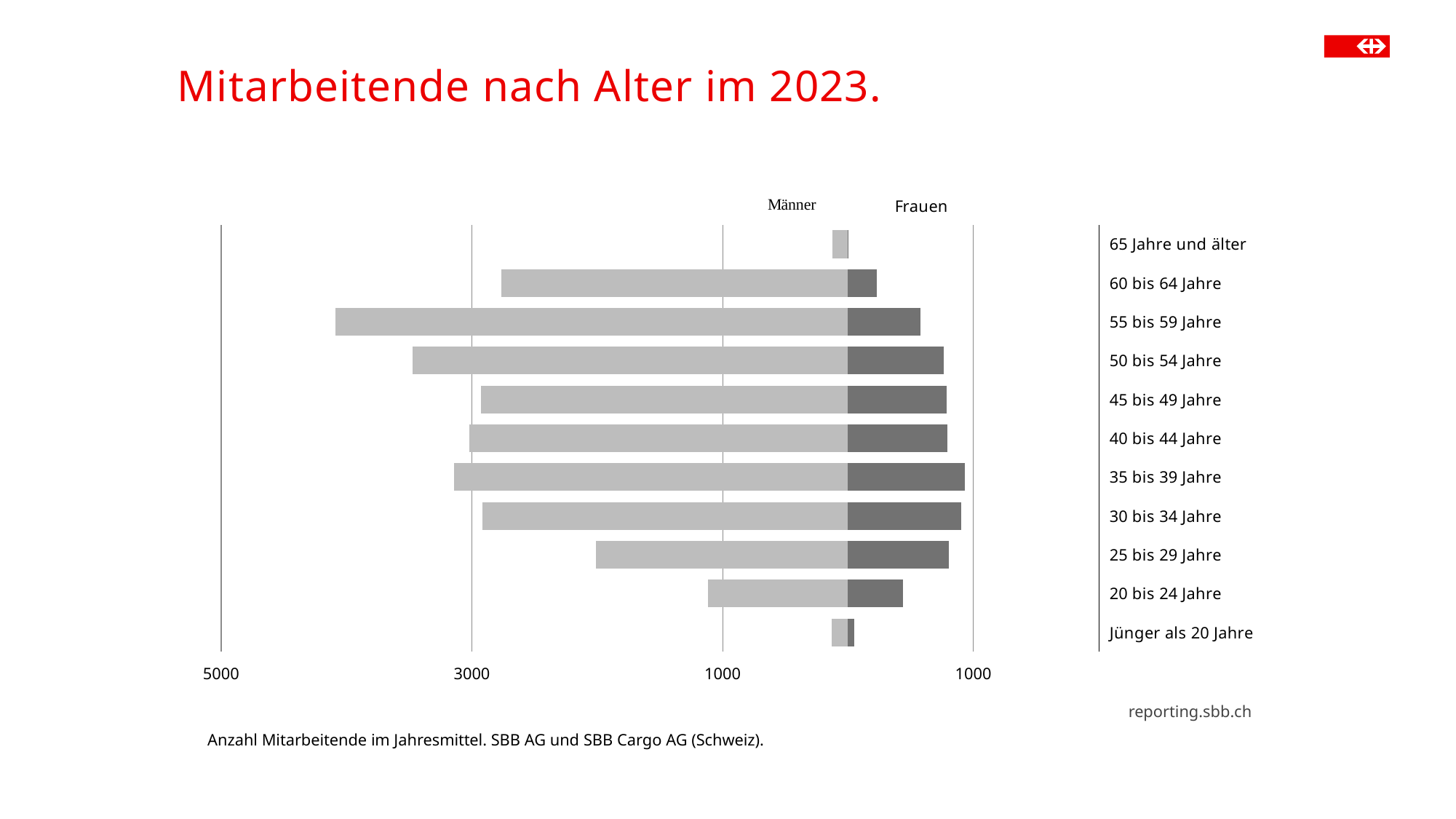
How many series does the chart show? 2 What is the title of the chart? Mitarbeitende nach Alter im 2023. Is the Männer value for 60 bis 64 Jahre greater or less than 3000? less Is the Männer value for 55 bis 59 Jahre greater or less than 3000? greater Which is larger for Männer: 55 bis 59 Jahre or 50 bis 54 Jahre? 55 bis 59 Jahre Is the Frauen value for 20 bis 24 Jahre greater or less than 1000? less Which age category has the highest value for Männer? 55 bis 59 Jahre Which age category has the lowest value for Frauen? 65 Jahre und älter Which is larger for Frauen: 50 bis 54 Jahre or 60 bis 64 Jahre? 50 bis 54 Jahre How many age categories are shown in the chart? 11 What kind of chart is shown on the slide? bar chart